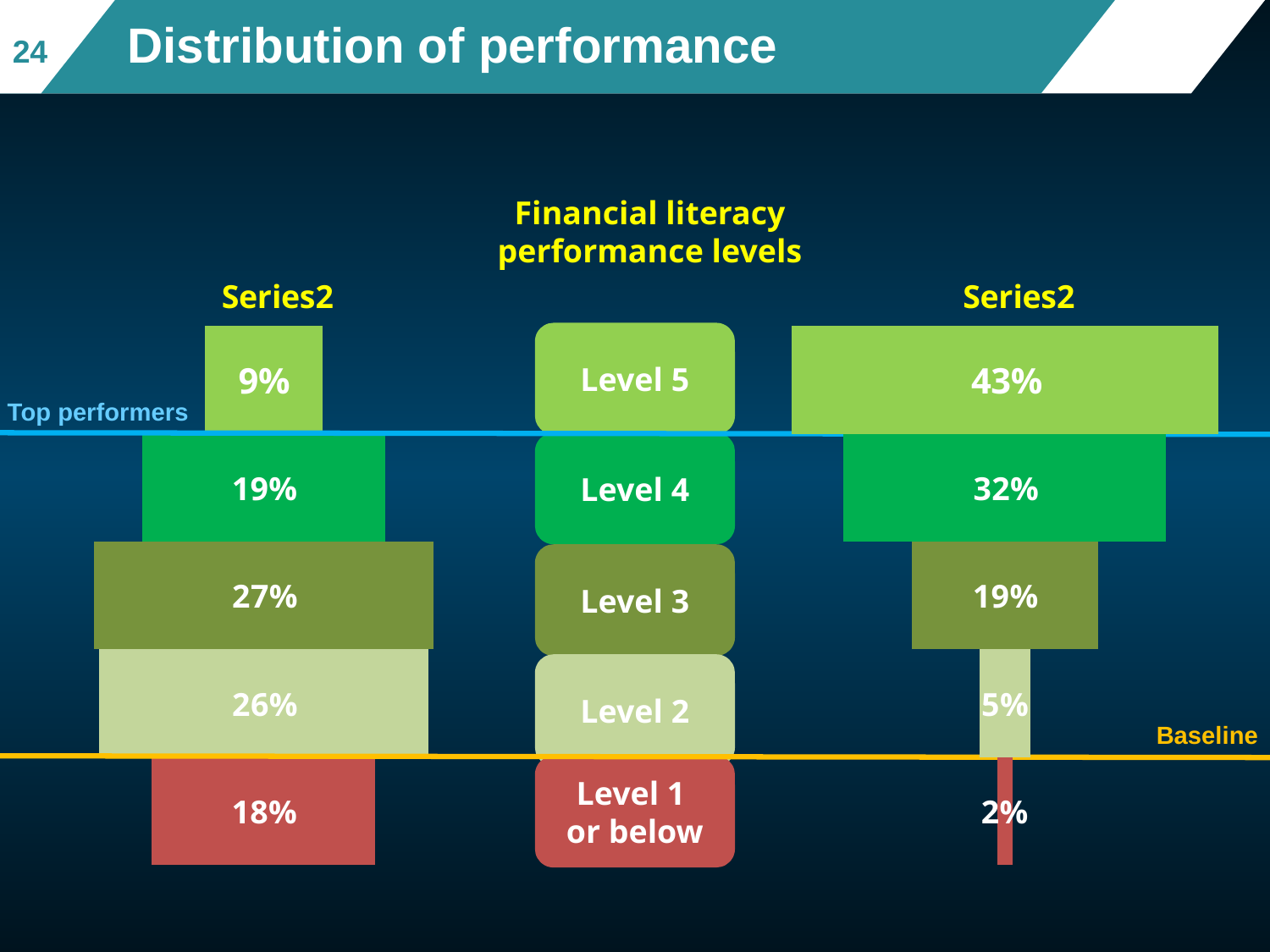
What kind of chart is used on this slide? Bar chart In the right chart, which level has the highest value? Level 5 How many performance levels are shown in each chart? 5 In the left chart, what is the value for Level 5? 9% In the right chart, what is the value for Level 1 or below? 2% In the left chart, which is larger: the value for Level 4 or the value for Level 2? Level 2 In the left chart, which level has the highest value? Level 3 In the right chart, what is the value for Level 4? 32% In the left chart, what is the difference between the Level 3 value and the Level 1 or below value? 9 percentage points In the right chart, which level has the lowest value? Level 1 or below What is the difference between the Level 5 values in the right chart and the left chart? 34 percentage points What is the title shown above the central column of level labels? Financial literacy performance levels